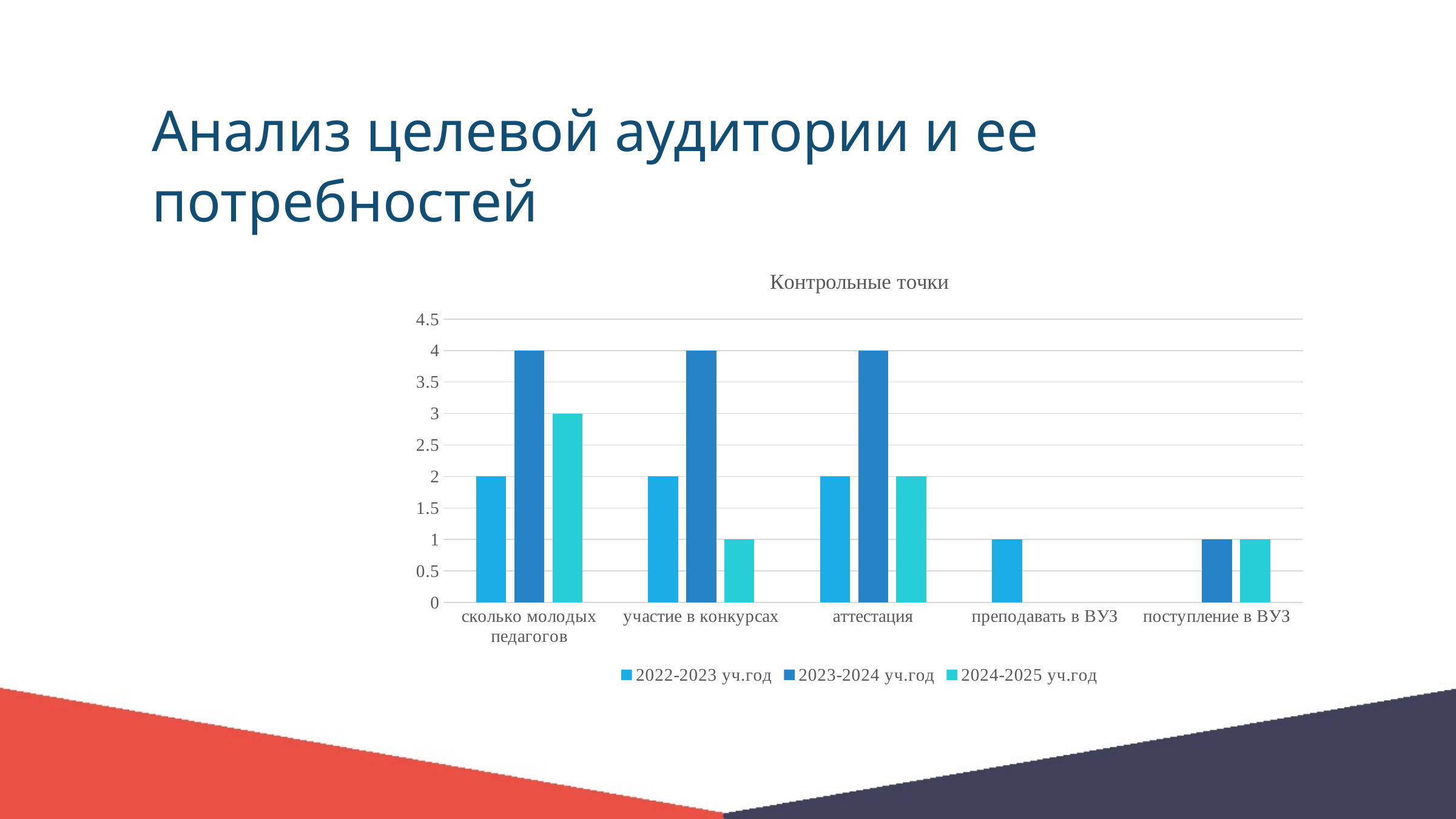
What is the difference between the 2023-2024 уч.год and 2024-2025 уч.год values for 'сколько молодых педагогов'? 1 What kind of chart is shown on the slide? bar chart What is the title of the chart? Контрольные точки What is the value for 'участие в конкурсах' in the 2024-2025 уч.год series? 1 What is the value for 'поступление в ВУЗ' in the 2024-2025 уч.год series? 1 How many categories are shown on the x axis? 5 Which category has the lowest value in the 2022-2023 уч.год series among those with a visible bar? преподавать в ВУЗ Which is larger for 'участие в конкурсах': the 2022-2023 уч.год value or the 2023-2024 уч.год value? 2023-2024 уч.год What is the value for 'аттестация' in the 2022-2023 уч.год series? 2 Is the value for 'аттестация' in the 2023-2024 уч.год series greater or less than 3? greater What is the value for 'сколько молодых педагогов' in the 2023-2024 уч.год series? 4 How many series does the legend list? 3